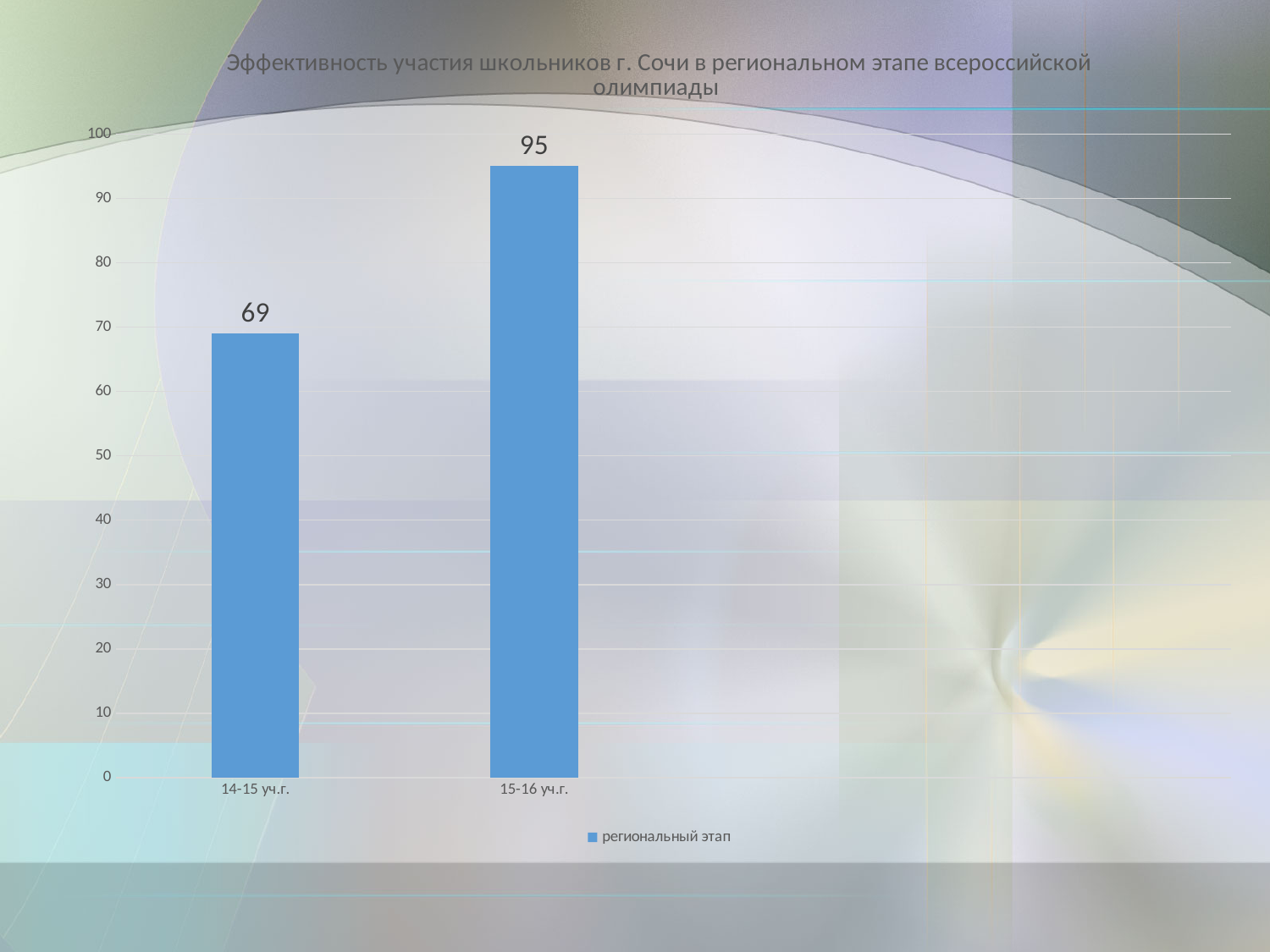
What is the difference between the values for 15-16 уч.г. and 14-15 уч.г.? 26 Is the value for 15-16 уч.г. greater or less than 90? greater Which category has the highest value? 15-16 уч.г. What is the value for 15-16 уч.г.? 95 What kind of chart is shown on the slide? bar chart Which category has the lowest value? 14-15 уч.г. How many categories are shown on the x axis? 2 Is the value for 14-15 уч.г. greater or less than 70? less What is the name of the series in the legend? региональный этап What is the value for 14-15 уч.г.? 69 Which is larger, the value for 14-15 уч.г. or the value for 15-16 уч.г.? 15-16 уч.г. How many series does the legend list? 1